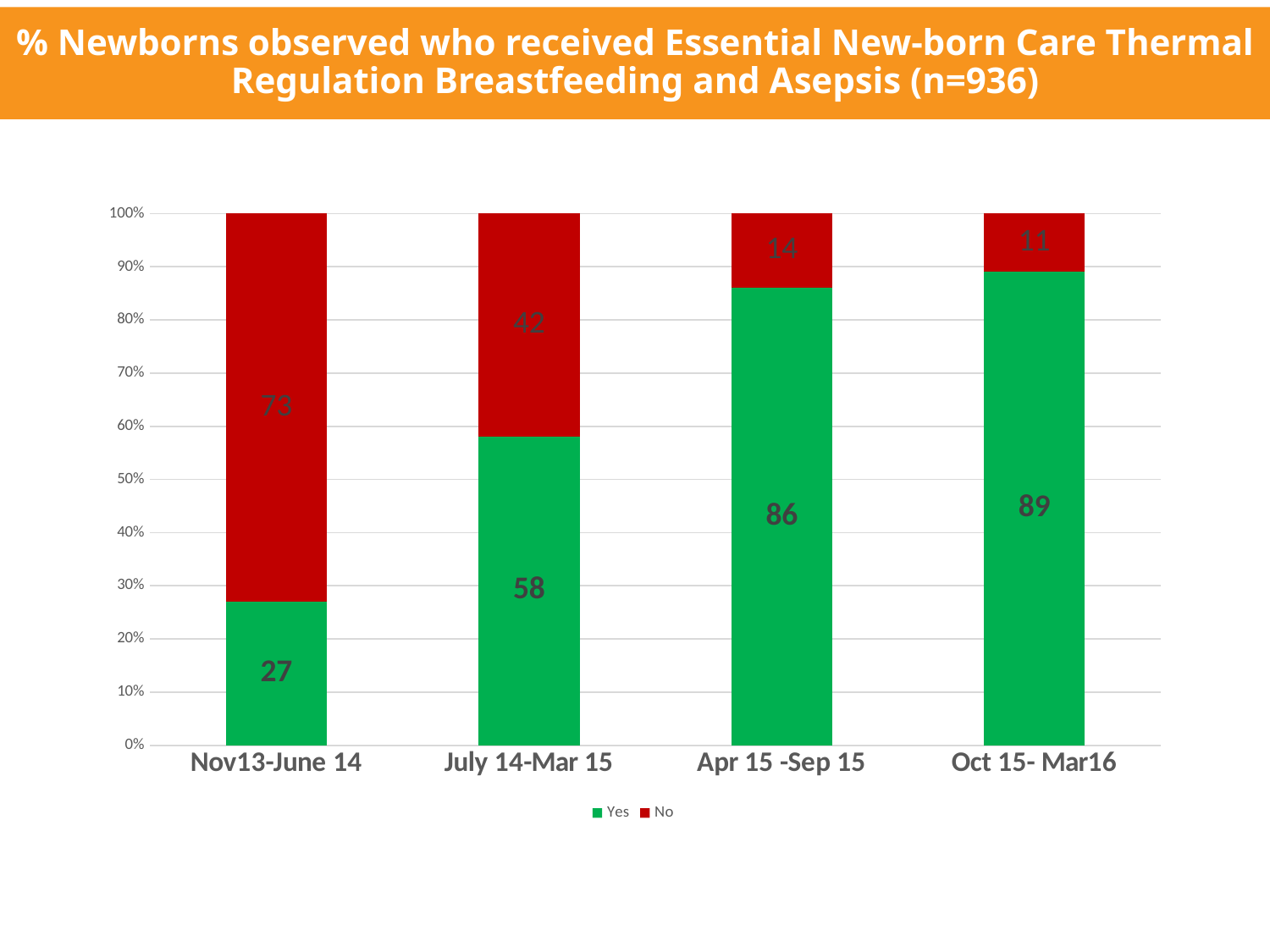
Which period has the highest 'Yes' value? Oct 15- Mar16 How many series does the legend list? 2 What kind of chart is shown? Stacked bar chart Does the 'Yes' value rise or fall across the periods from left to right? Rise What is the difference between the 'Yes' values for Apr 15 -Sep 15 and July 14-Mar 15? 28 Which period has the lowest 'Yes' value? Nov13-June 14 What is the 'No' value for July 14-Mar 15? 42 What is the 'No' value for Apr 15 -Sep 15? 14 What is the 'Yes' value for Oct 15- Mar16? 89 How many periods are shown on the x axis? 4 Which is larger: the 'No' value for Nov13-June 14 or the 'No' value for July 14-Mar 15? Nov13-June 14 What is the 'Yes' value for Nov13-June 14? 27